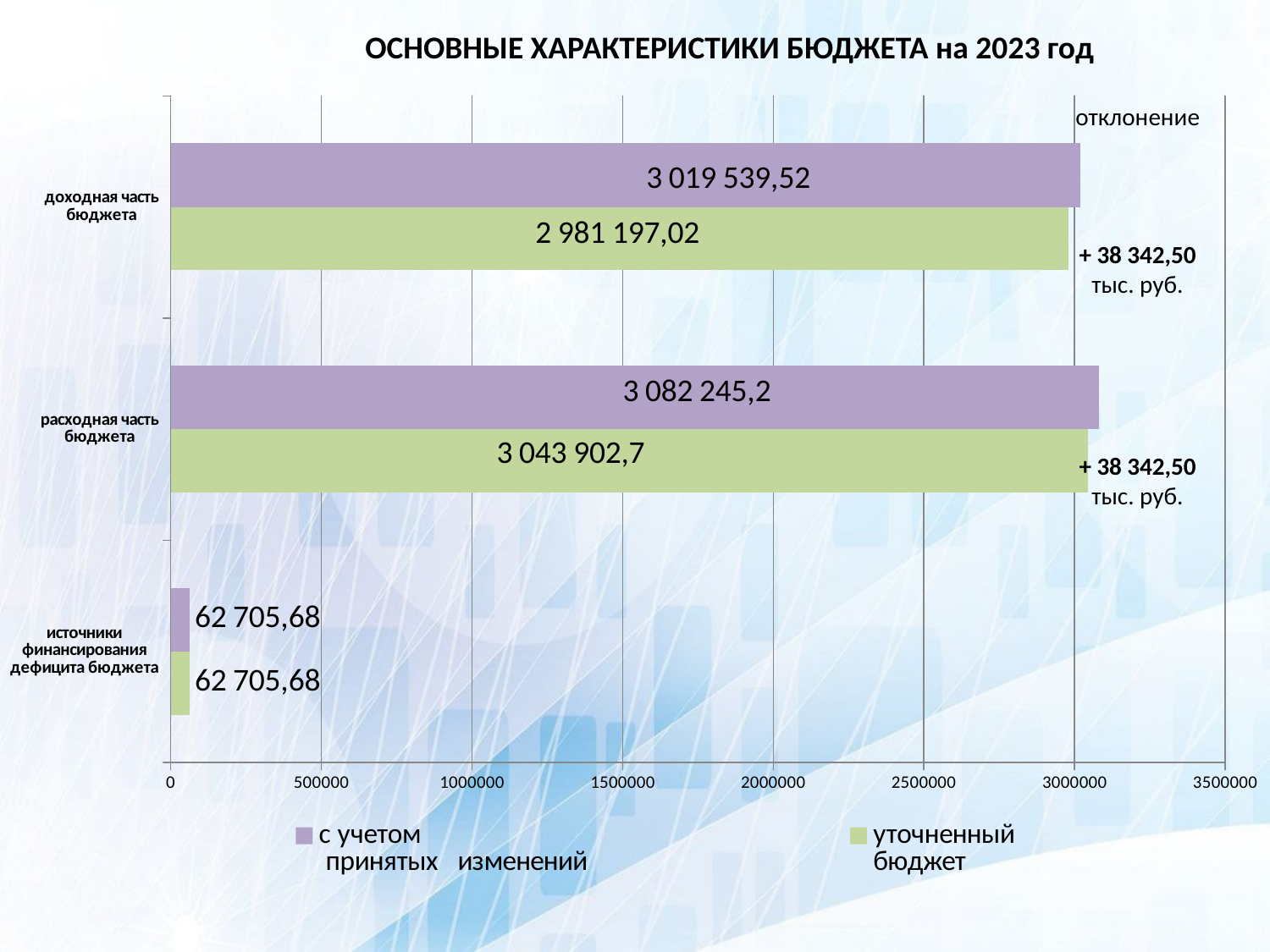
Which is larger for расходная часть бюджета: с учетом принятых изменений or уточненный бюджет? с учетом принятых изменений What is the value for расходная часть бюджета in the series уточненный бюджет? 3 043 902,7 What is the value for источники финансирования дефицита бюджета in the series уточненный бюджет? 62 705,68 How many categories are shown on the chart? 3 What is the value for доходная часть бюджета in the series уточненный бюджет? 2 981 197,02 What is the value for расходная часть бюджета in the series с учетом принятых изменений? 3 082 245,2 What is the difference between the two series for доходная часть бюджета? 38 342,50 Which category has the highest value in the series с учетом принятых изменений? расходная часть бюджета How many series does the legend list? 2 What is the value for доходная часть бюджета in the series с учетом принятых изменений? 3 019 539,52 Which category has the lowest value in the series уточненный бюджет? источники финансирования дефицита бюджета Is the value for источники финансирования дефицита бюджета in the series с учетом принятых изменений greater or less than 500000? less